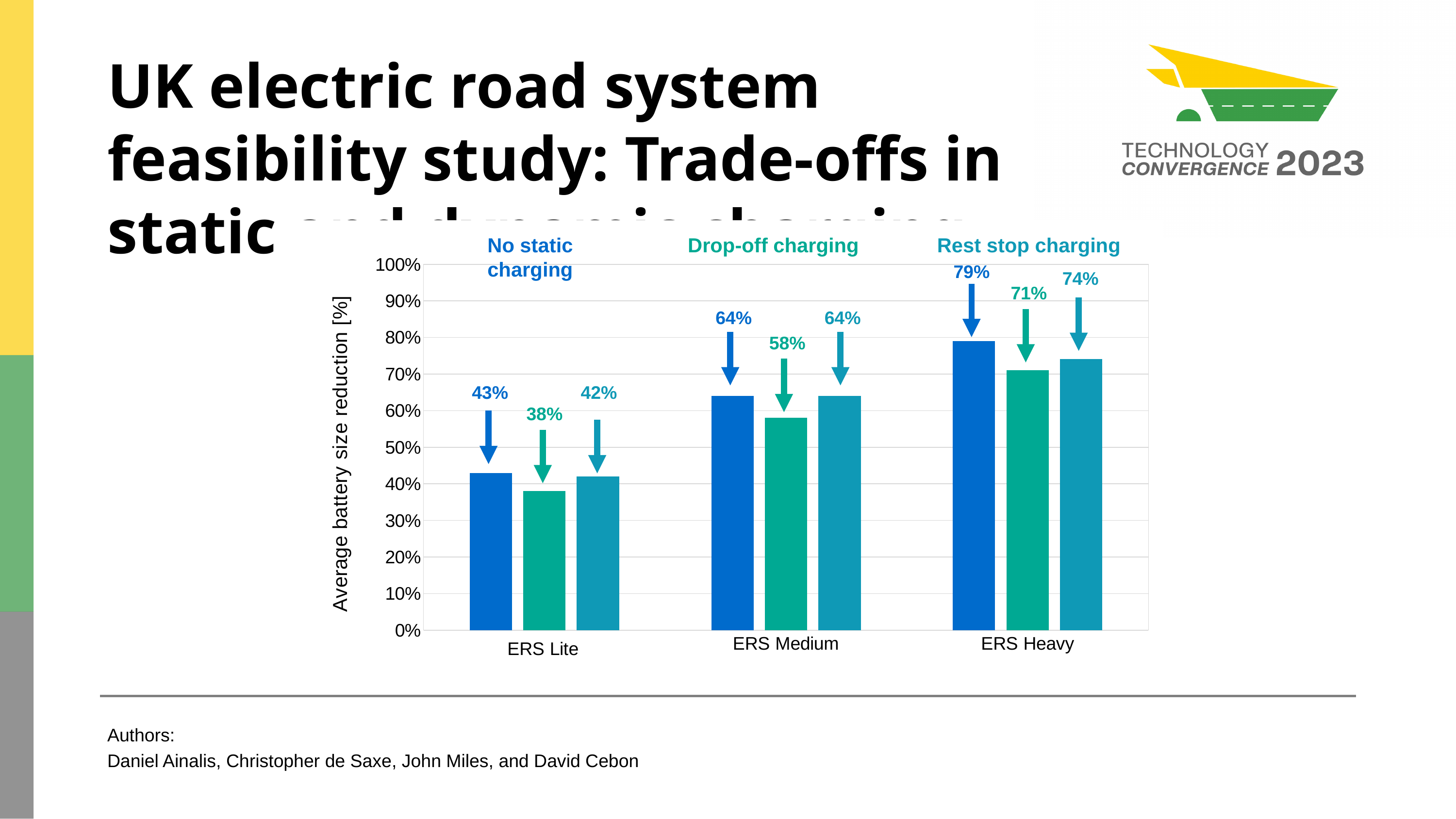
Which ERS category has the lowest average battery size reduction with drop-off charging? ERS Lite What is the average battery size reduction for ERS Medium with drop-off charging? 58% What is the average battery size reduction for ERS Heavy with rest stop charging? 74% What is the average battery size reduction for ERS Lite with no static charging? 43% Which ERS category has the highest average battery size reduction with no static charging? ERS Heavy How many charging scenarios (series) are plotted in the chart? 3 Is the rest stop charging value for ERS Medium greater or less than 50%? greater What is the label of the y axis of the chart? Average battery size reduction [%] What kind of chart is shown on the slide? Bar chart What is the difference between the no static charging and drop-off charging values for ERS Heavy? 8% For ERS Lite, which is larger: the no static charging value or the drop-off charging value? No static charging How many ERS categories are shown on the x axis? 3